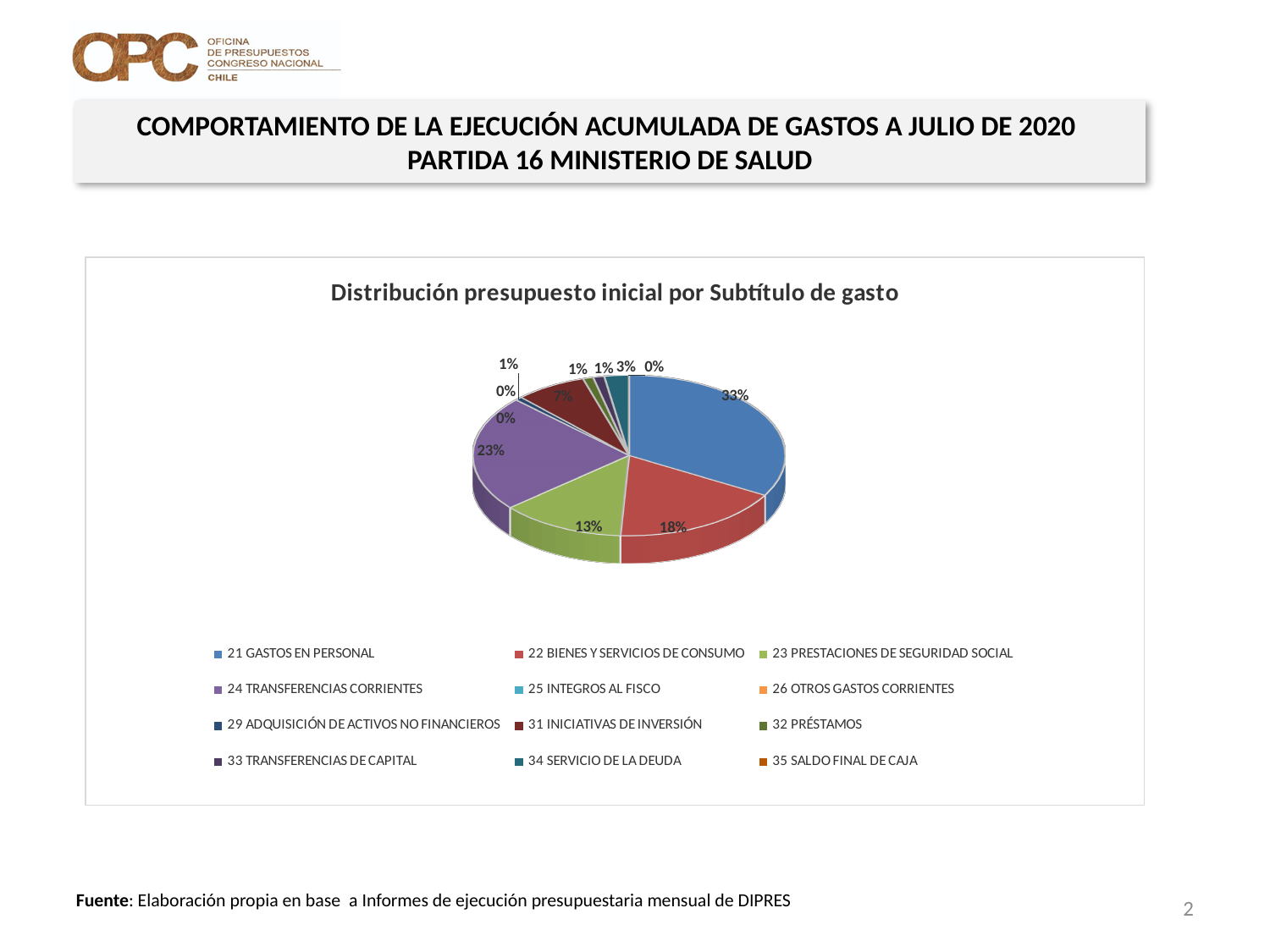
How many categories does the legend list? 12 What share of the pie does 34 SERVICIO DE LA DEUDA represent? 3% Which has a larger share: 24 TRANSFERENCIAS CORRIENTES or 22 BIENES Y SERVICIOS DE CONSUMO? 24 TRANSFERENCIAS CORRIENTES What share of the pie does 21 GASTOS EN PERSONAL represent? 33% What share of the pie does 24 TRANSFERENCIAS CORRIENTES represent? 23% What type of chart is shown on the slide? Pie chart Which subtítulo has the largest share of the pie? 21 GASTOS EN PERSONAL What is the difference in percentage points between the share of 21 GASTOS EN PERSONAL and 22 BIENES Y SERVICIOS DE CONSUMO? 15 percentage points What is the title of the chart? Distribución presupuesto inicial por Subtítulo de gasto